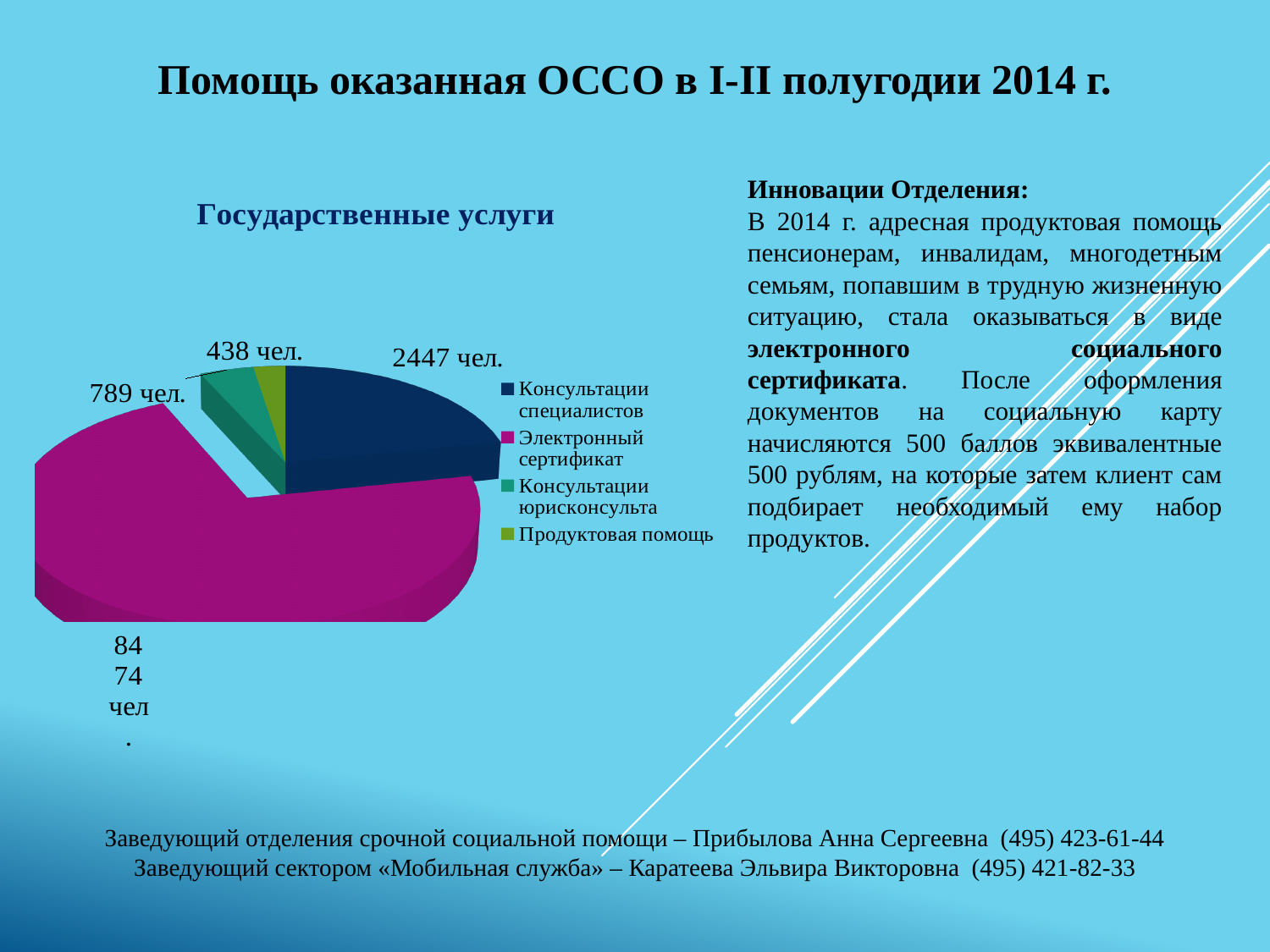
How many slices does the "Государственные услуги" pie chart have? 4 Which category has the largest slice in the "Государственные услуги" pie chart? Электронный сертификат What value is shown for "Электронный сертификат" in the pie chart? 8474 чел. By how much does "Консультации специалистов" exceed "Консультации юрисконсульта" in the pie chart? 1658 чел. What kind of chart is shown under the heading "Государственные услуги"? pie chart What value is shown for "Консультации юрисконсульта" in the pie chart? 789 чел. Which is larger in the pie chart: "Консультации специалистов" or "Консультации юрисконсульта"? Консультации специалистов Which category has the smallest slice in the "Государственные услуги" pie chart? Продуктовая помощь How many entries does the legend of the "Государственные услуги" chart list? 4 What value is shown for "Продуктовая помощь" in the pie chart? 438 чел. What is the title of the pie chart on the slide? Государственные услуги What value is shown for "Консультации специалистов" in the pie chart? 2447 чел.